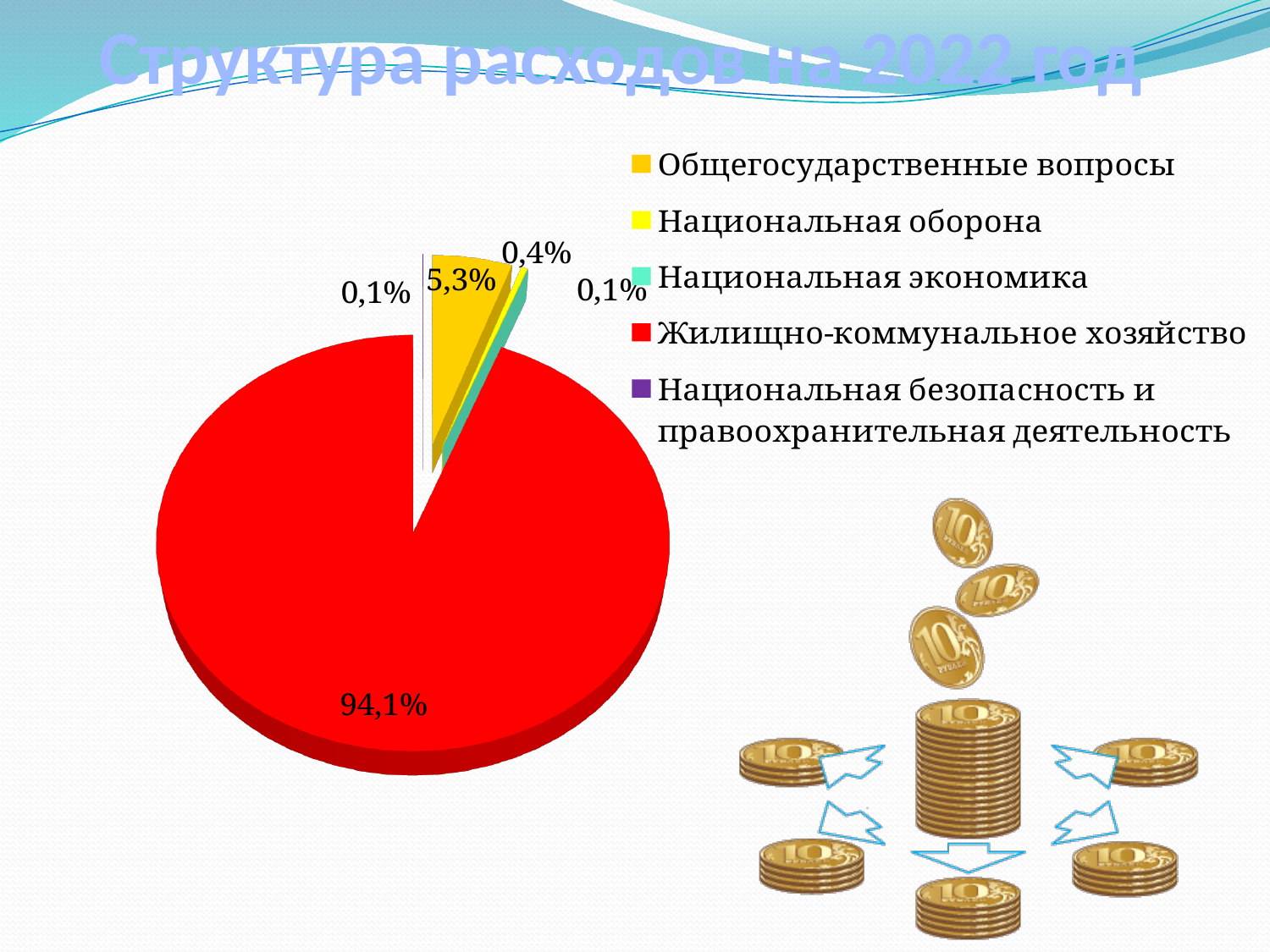
What is the difference between the value for Жилищно-коммунальное хозяйство and the value for Общегосударственные вопросы? 88,8% What is the title of the chart on the slide? Структура расходов на 2022 год Which is larger, the slice for Общегосударственные вопросы or the slice for Жилищно-коммунальное хозяйство? Жилищно-коммунальное хозяйство Which category has the largest slice of the pie? Жилищно-коммунальное хозяйство How many slices are labelled 0,1%? 2 How many categories does the legend list? 5 What share of the pie does Жилищно-коммунальное хозяйство take? 94,1% What is the value shown for Общегосударственные вопросы? 5,3% What is the smallest percentage value labelled on the pie? 0,1% Is the value for Общегосударственные вопросы greater or less than 10%? less What kind of chart is shown on the slide? pie chart What colour is the slice for Жилищно-коммунальное хозяйство? red